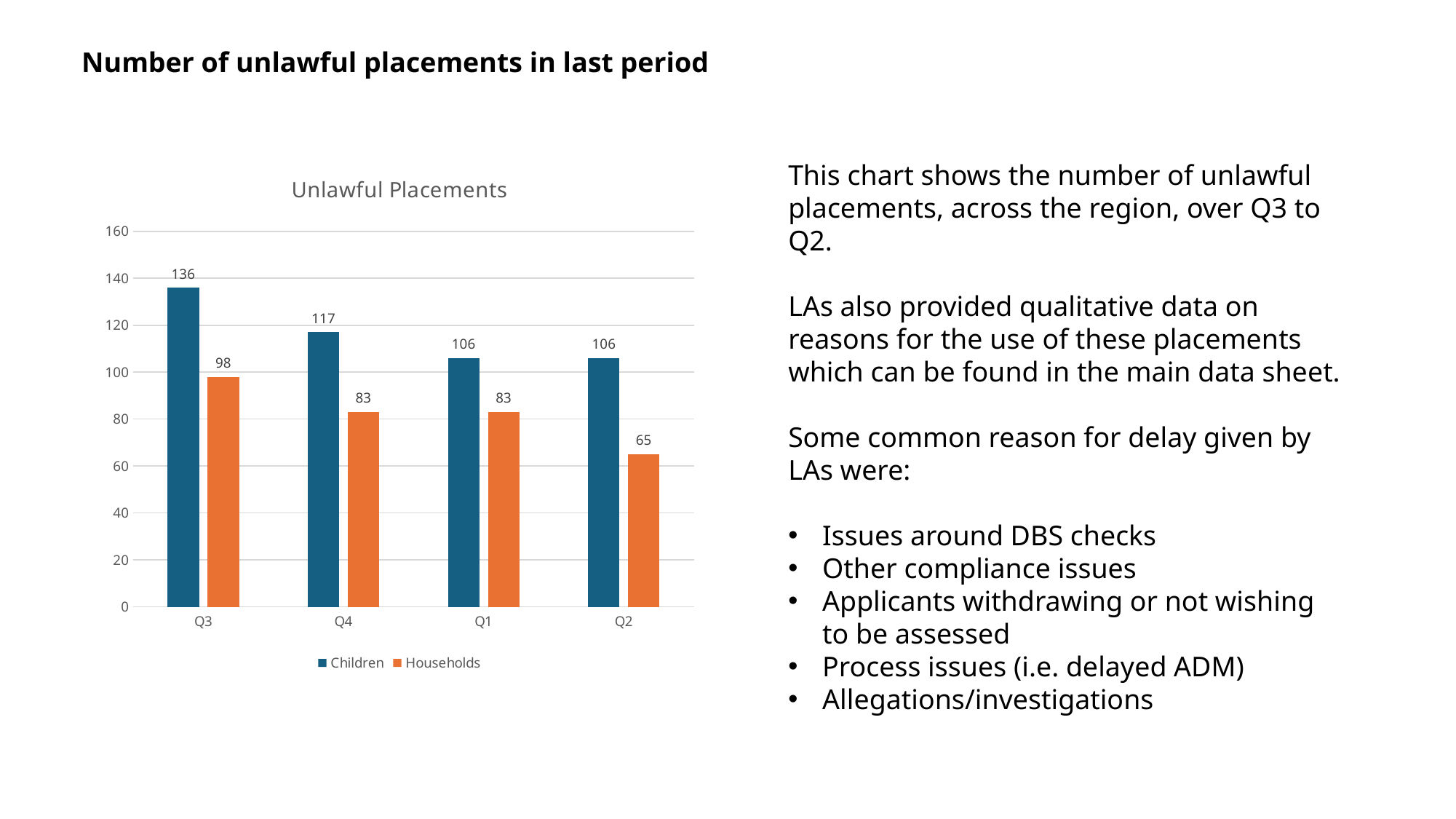
What is the value for Households in Q2? 65 What is the value for Households in Q4? 83 What is the difference between the Children values for Q3 and Q2? 30 How many quarters are shown on the x axis? 4 Which quarter has the highest value for Children? Q3 How many series does the legend list? 2 What is the value for Children in Q3? 136 Which quarter has the lowest value for Households? Q2 What kind of chart is shown? Bar chart What is the difference between Children and Households in Q3? 38 Which is larger, Households in Q3 or Households in Q1? Households in Q3 What is the title of the chart? Unlawful Placements